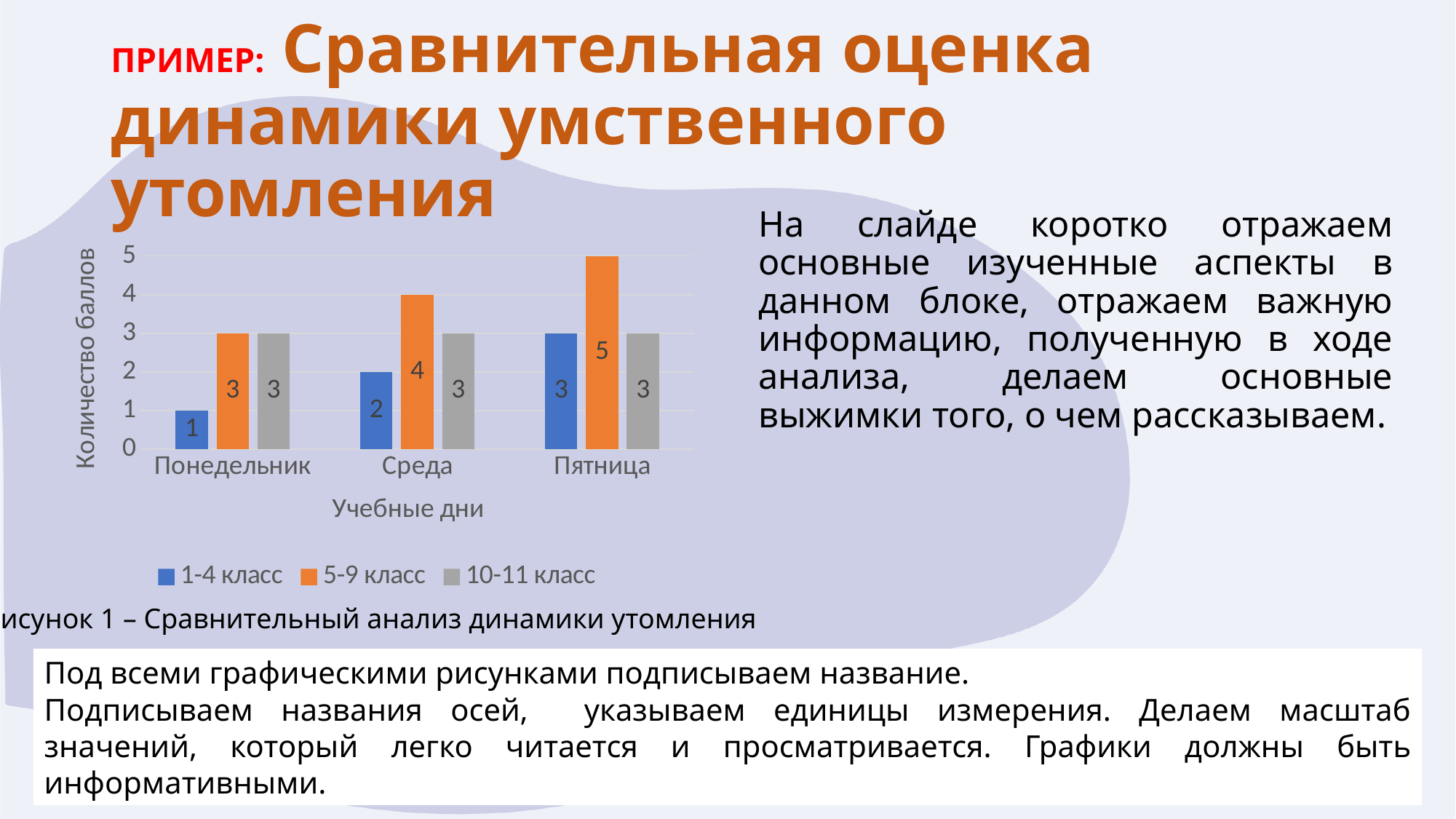
What kind of chart is shown on the slide? Bar chart On which day does the 1-4 класс series have its lowest value? Понедельник What is the difference between the 5-9 класс and 1-4 класс values on Пятница? 2 How many series does the legend list? 3 What is the value for 5-9 класс on Среда? 4 Which is larger on Среда: the value for 5-9 класс or for 10-11 класс? 5-9 класс What is the label of the vertical axis of the chart? Количество баллов What is the value for 1-4 класс on Понедельник? 1 On which day does the 5-9 класс series reach its highest value? Пятница How many days (categories) are shown on the x axis? 3 What is the value for 10-11 класс on Пятница? 3 Does the 1-4 класс series rise or fall from Понедельник to Пятница? Rises